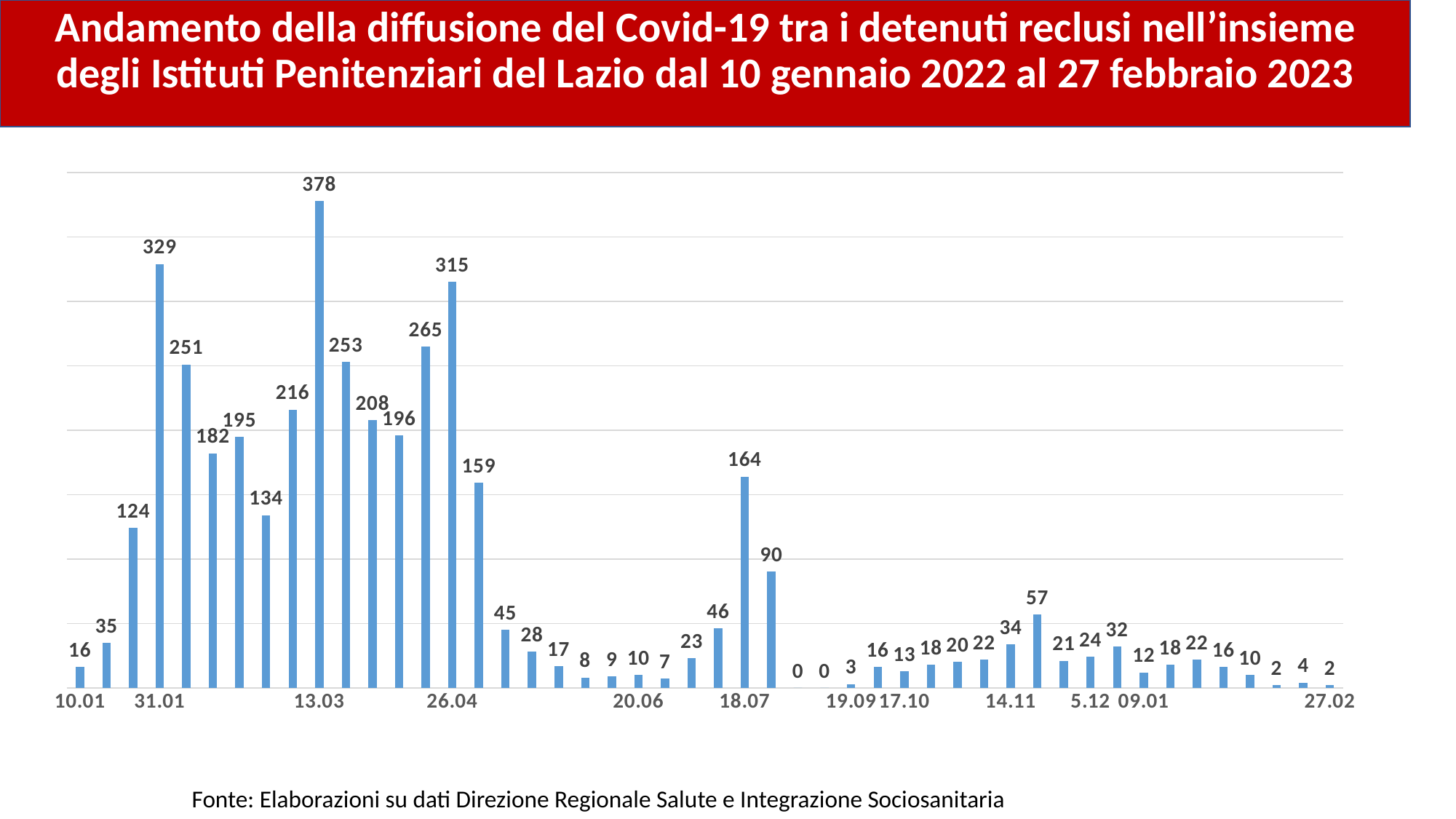
What is the source cited below the chart? Elaborazioni su dati Direzione Regionale Salute e Integrazione Sociosanitaria Do the values rise or fall from 13.03 to 20.06? fall What is the value for 31.01? 329 What is the value for 18.07? 164 What is the value for 13.03? 378 Which is larger, the value for 18.07 or the value for 14.11? 18.07 What kind of chart is shown on the slide? bar chart What is the difference between the values for 13.03 and 31.01? 49 What is the lowest value shown on the chart? 0 What is the value for 27.02? 2 What is the value for 10.01? 16 Which date has the highest value? 13.03